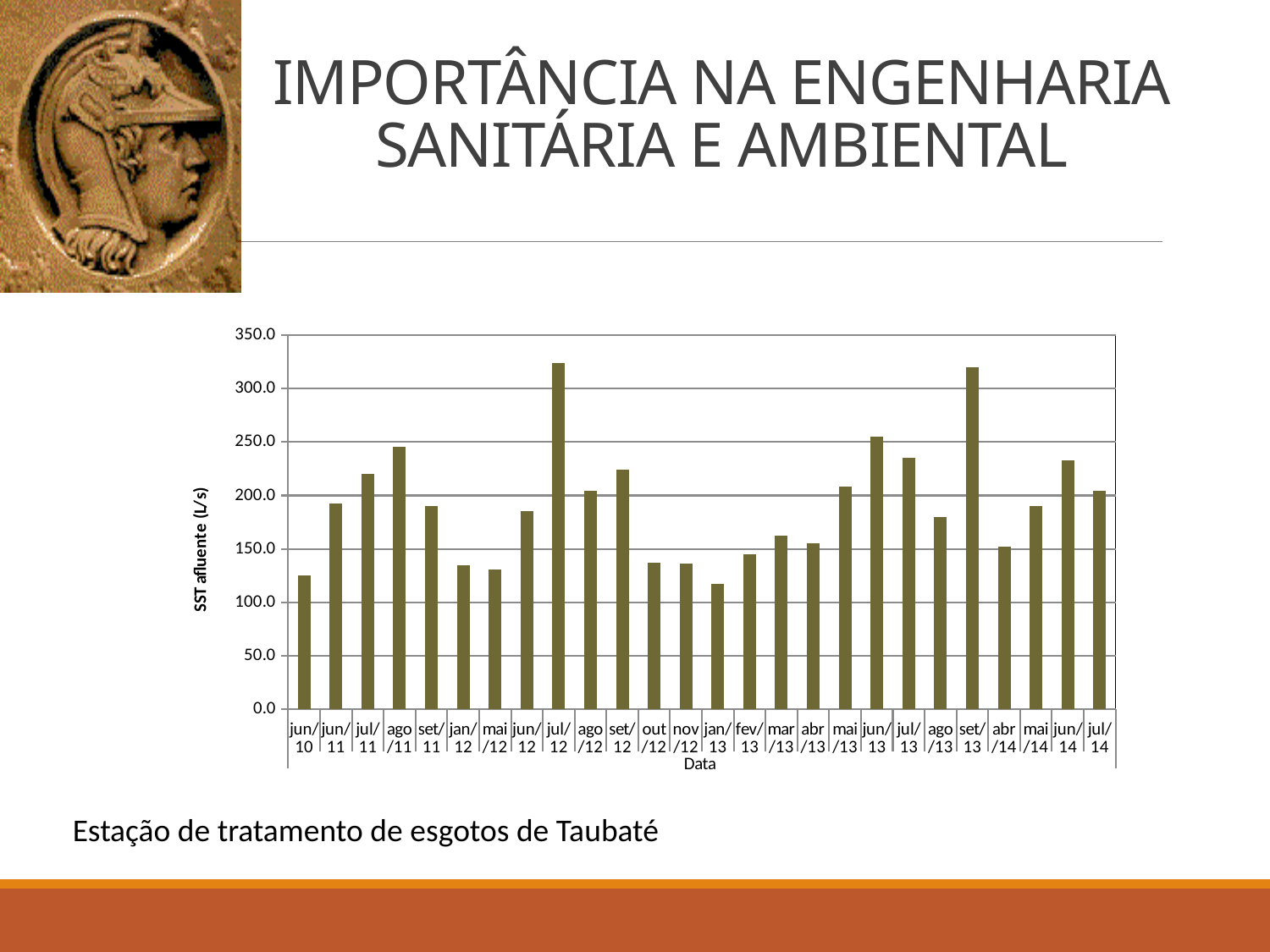
Is the value for jan/12 greater or less than 150.0? less Is the value for jul/12 greater or less than 300.0? greater Is the value for ago/13 greater or less than 200.0? less Which has the larger value, jul/12 or jan/13? jul/12 What is the label of the horizontal axis of the chart? Data How many bars (dates) are plotted in the chart? 26 Which has the larger value, ago/11 or set/11? ago/11 What is the label of the vertical axis of the chart? SST afluente (L/s) What kind of chart is shown on the slide? bar chart